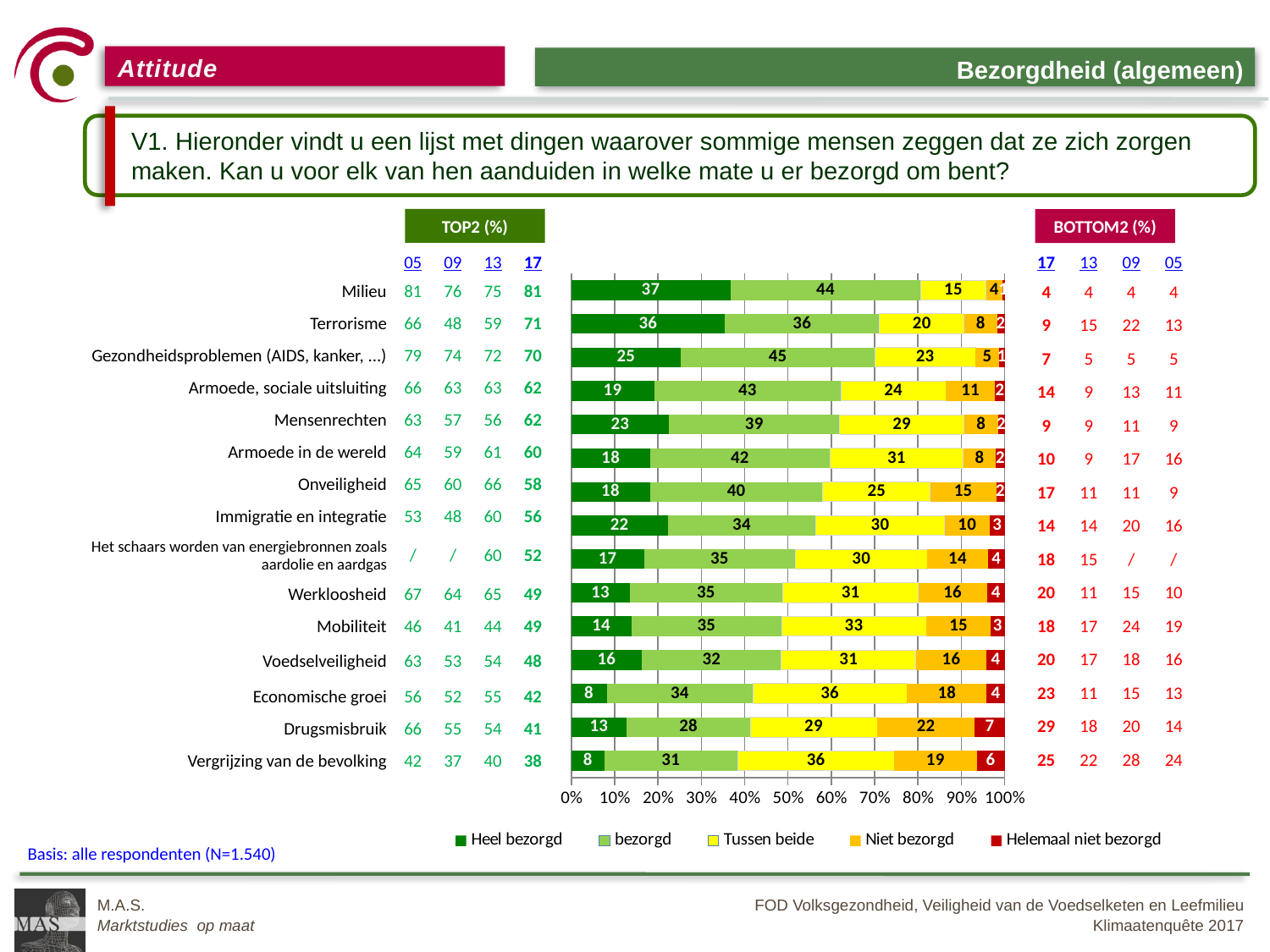
What is the difference between the 'bezorgd' values for Gezondheidsproblemen (AIDS, kanker, ...) and Terrorisme? 9 Which category has the highest 'Helemaal niet bezorgd' value? Drugsmisbruik What is the 'Tussen beide' value for Economische groei? 36 How many series does the chart legend list? 5 Which legend entry is shown in dark green? Heel bezorgd Which category has the highest 'Heel bezorgd' value? Milieu What is the 'Niet bezorgd' value for Drugsmisbruik? 22 What type of chart is shown on the slide? stacked bar chart Which category has the lowest 'bezorgd' value? Drugsmisbruik How many categories (items) are plotted in the chart? 15 What is the 'Heel bezorgd' value for Milieu? 37 Which has a larger 'Heel bezorgd' value: Terrorisme or Mensenrechten? Terrorisme